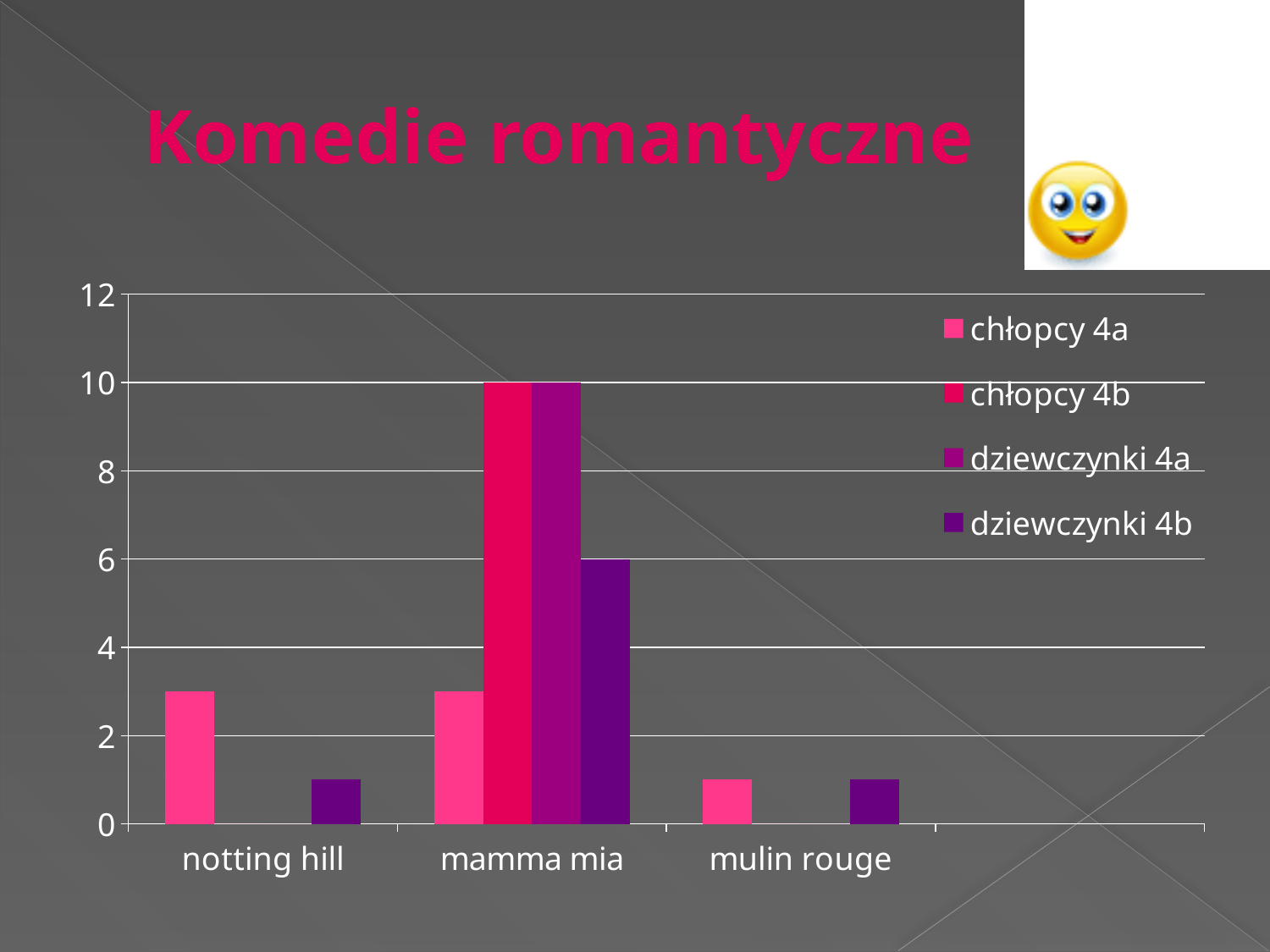
Is the value for dziewczynki 4b for mulin rouge greater or less than 2? less Which film has the highest bar in the chart? mamma mia Is the value for chłopcy 4a for notting hill greater or less than 2? greater For mamma mia, which is larger: chłopcy 4b or dziewczynki 4b? chłopcy 4b What kind of chart is shown on the slide? bar chart What is the value for chłopcy 4b for mamma mia? 10 How many labelled categories are shown on the x axis? 3 What is the value for dziewczynki 4a for mamma mia? 10 What is the difference between chłopcy 4b and dziewczynki 4b for mamma mia? 4 What is the value for dziewczynki 4b for mamma mia? 6 How many series does the legend list? 4 What is the title of the chart on the slide? Komedie romantyczne